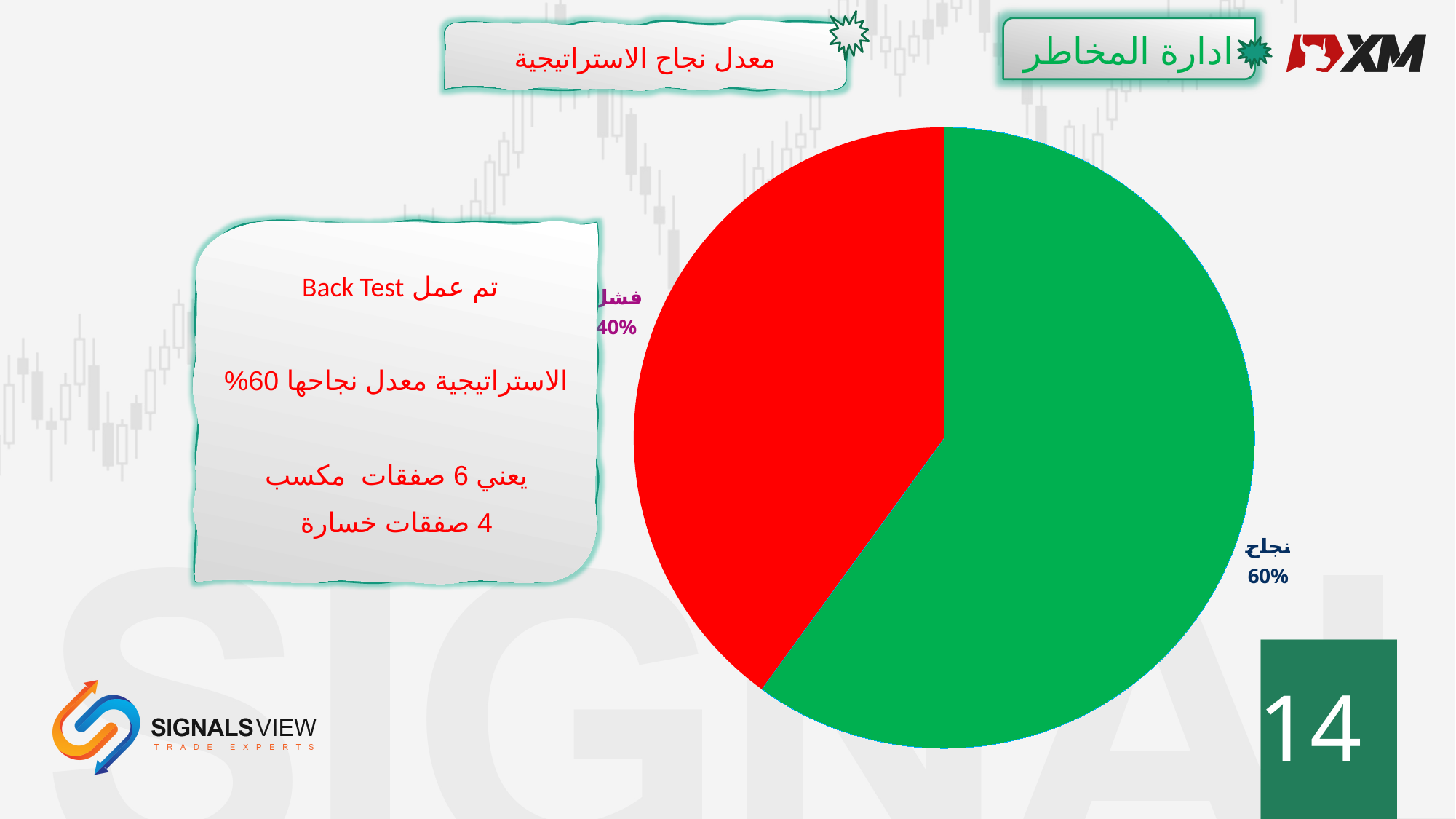
What share of the pie does the نجاح (success) slice represent? 60% Which is larger, the فشل slice or the نجاح slice? نجاح How many slices does the pie chart have? 2 What colour is the فشل (failure) slice of the pie chart? red What is the difference in percentage points between the نجاح slice and the فشل slice? 20% Which slice of the pie chart is the largest? نجاح (success) What share of the pie does the فشل (failure) slice represent? 40% What colour is the نجاح (success) slice of the pie chart? green Which slice of the pie chart is the smallest? فشل (failure) Is the share of the فشل slice greater or less than 50%? less What kind of chart is shown on the slide? pie chart